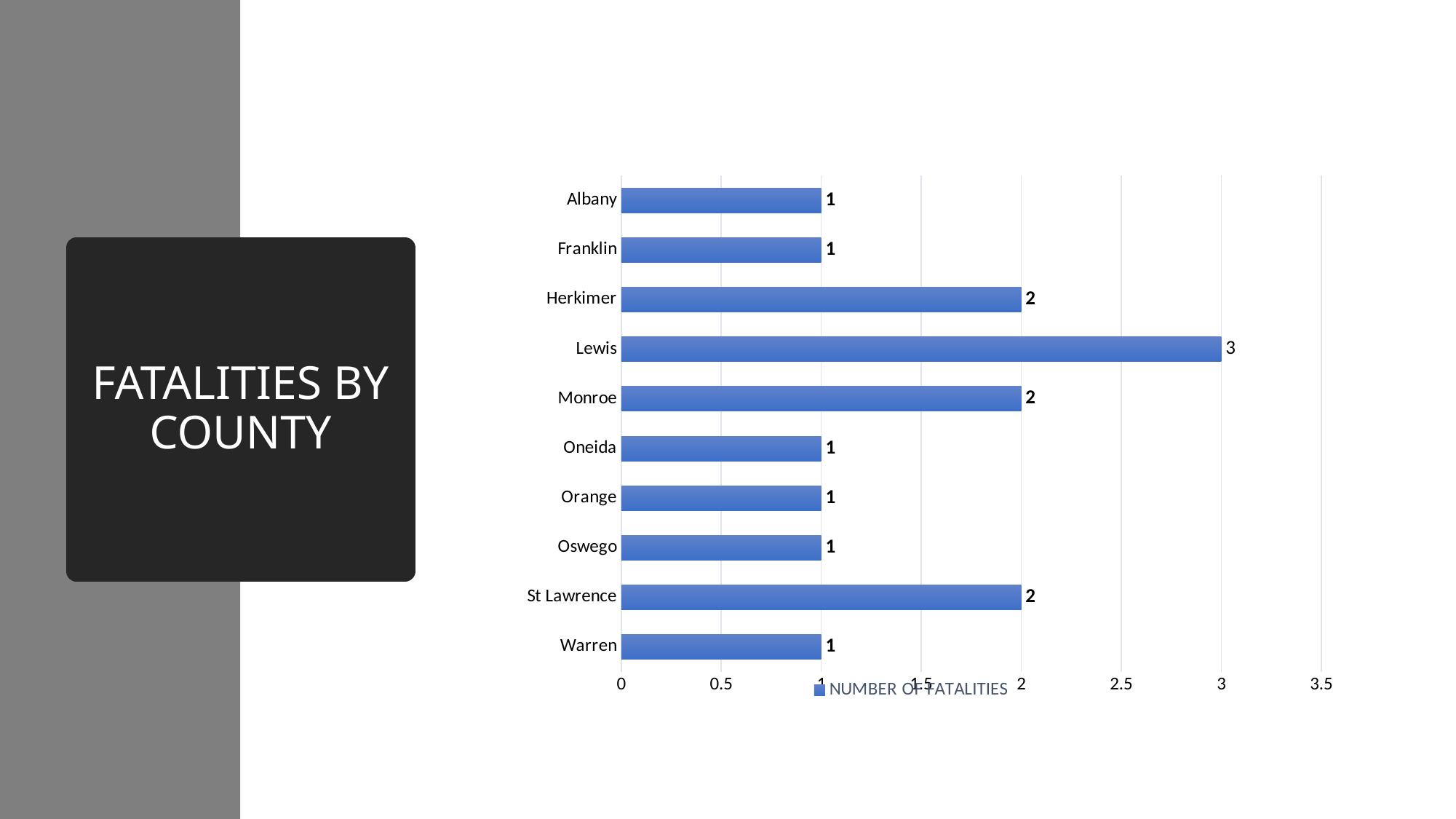
What is the title of the slide? FATALITIES BY COUNTY Which has more fatalities, Monroe or Oneida? Monroe Which has more fatalities, Lewis or Herkimer? Lewis What is the number of fatalities for Albany county? 1 Which county has the highest number of fatalities? Lewis What is the number of fatalities for Lewis county? 3 How many series does the legend list? 1 What is the number of fatalities for Herkimer county? 2 What is the difference in fatalities between St Lawrence and Oswego? 1 How many counties are shown in the chart? 10 What kind of chart is shown on the slide? Bar chart What is the difference in fatalities between Lewis and Monroe? 1